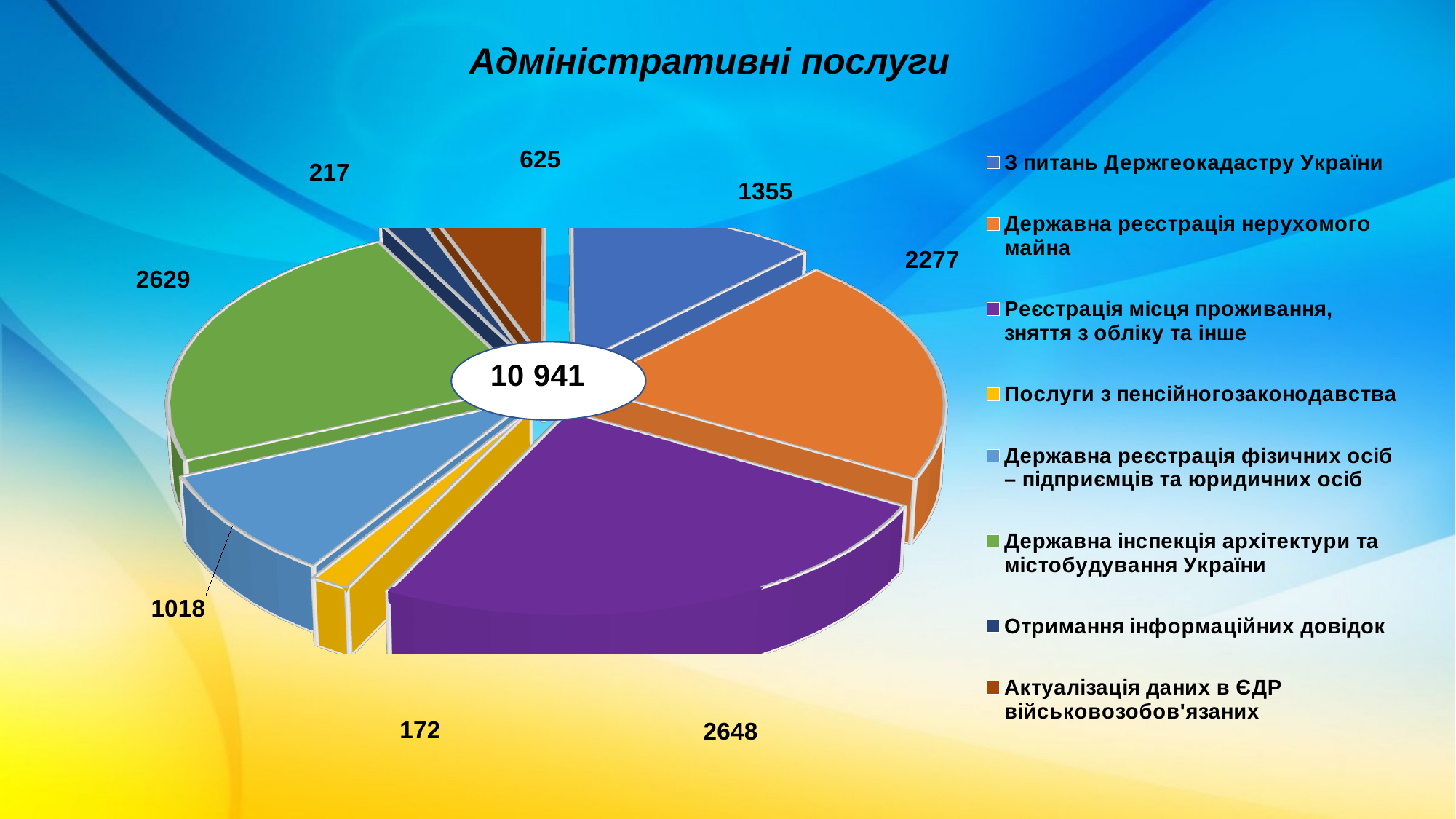
What total is shown in the centre of the pie chart? 10 941 Which category has the largest value? Реєстрація місця проживання, зняття з обліку та інше What is the value for 'Послуги з пенсійногозаконодавства'? 172 Which category has the smallest value? Послуги з пенсійногозаконодавства What is the difference between 'Державна інспекція архітектури та містобудування України' and 'Державна реєстрація фізичних осіб – підприємців та юридичних осіб'? 1611 What is the title of the chart? Адміністративні послуги What is the value for 'Державна реєстрація нерухомого майна'? 2277 Which is larger: 'З питань Держгеокадастру України' or 'Отримання інформаційних довідок'? З питань Держгеокадастру України What type of chart is shown on the slide? Pie chart What is the value for 'Актуалізація даних в ЄДР військовозобов'язаних'? 625 What is the value for 'Реєстрація місця проживання, зняття з обліку та інше'? 2648 How many categories (slices) does the pie chart have? 8